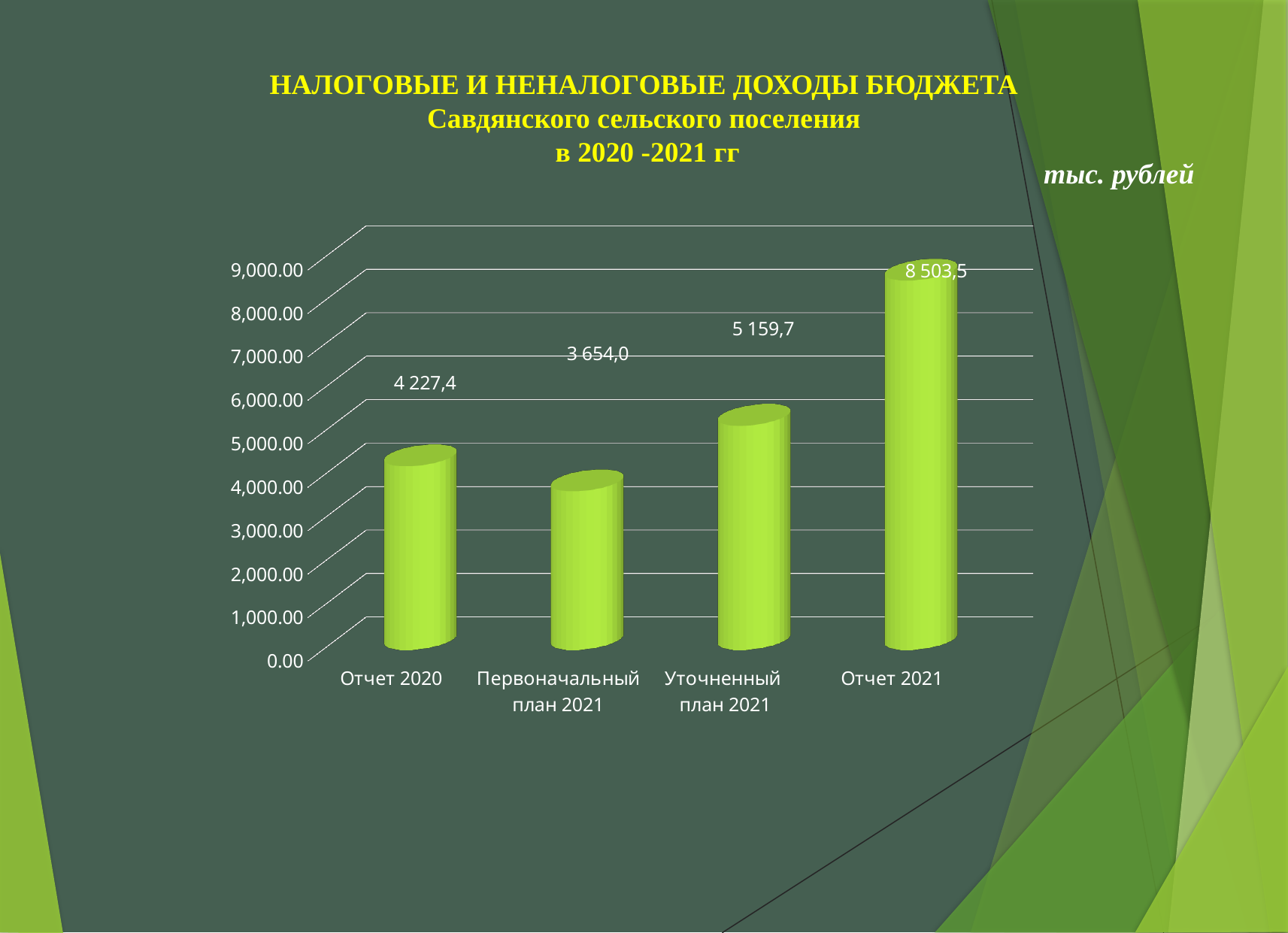
How many categories are shown on the x axis? 4 What is the value for Отчет 2021? 8 503,5 What is the difference between Отчет 2021 and Отчет 2020? 4 276,1 What is the value for Отчет 2020? 4 227,4 What kind of chart is shown on the slide? Bar chart What unit of measurement is indicated for the chart values? тыс. рублей Which category has the lowest value? Первоначальный план 2021 What is the value for Первоначальный план 2021? 3 654,0 Which category has the highest value? Отчет 2021 Which is larger, Уточненный план 2021 or Отчет 2020? Уточненный план 2021 What is the difference between Уточненный план 2021 and Первоначальный план 2021? 1 505,7 What is the value for Уточненный план 2021? 5 159,7